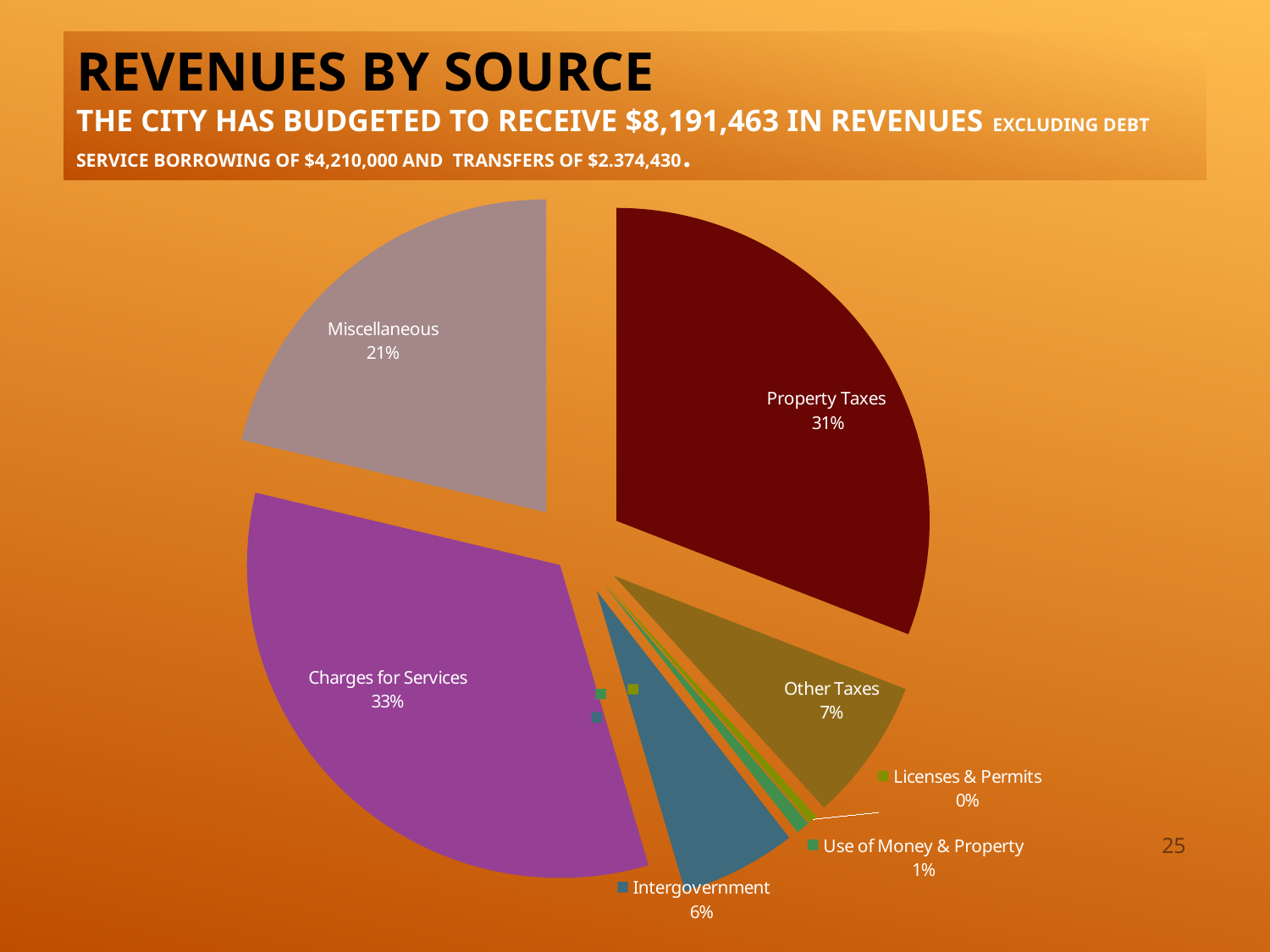
What share of revenues comes from Charges for Services? 33% What share of revenues comes from Other Taxes? 7% What share of revenues comes from Property Taxes? 31% Which revenue source has the largest share of the pie? Charges for Services Which revenue source has the smallest share of the pie? Licenses & Permits What share of revenues comes from Intergovernment? 6% Which is larger, the share for Other Taxes or the share for Intergovernment? Other Taxes What is the difference in percentage points between Charges for Services and Property Taxes? 2 What type of chart is shown on the slide? pie chart What share of revenues comes from Miscellaneous? 21% How many revenue sources are shown in the pie chart? 7 What share of revenues comes from Use of Money & Property? 1%